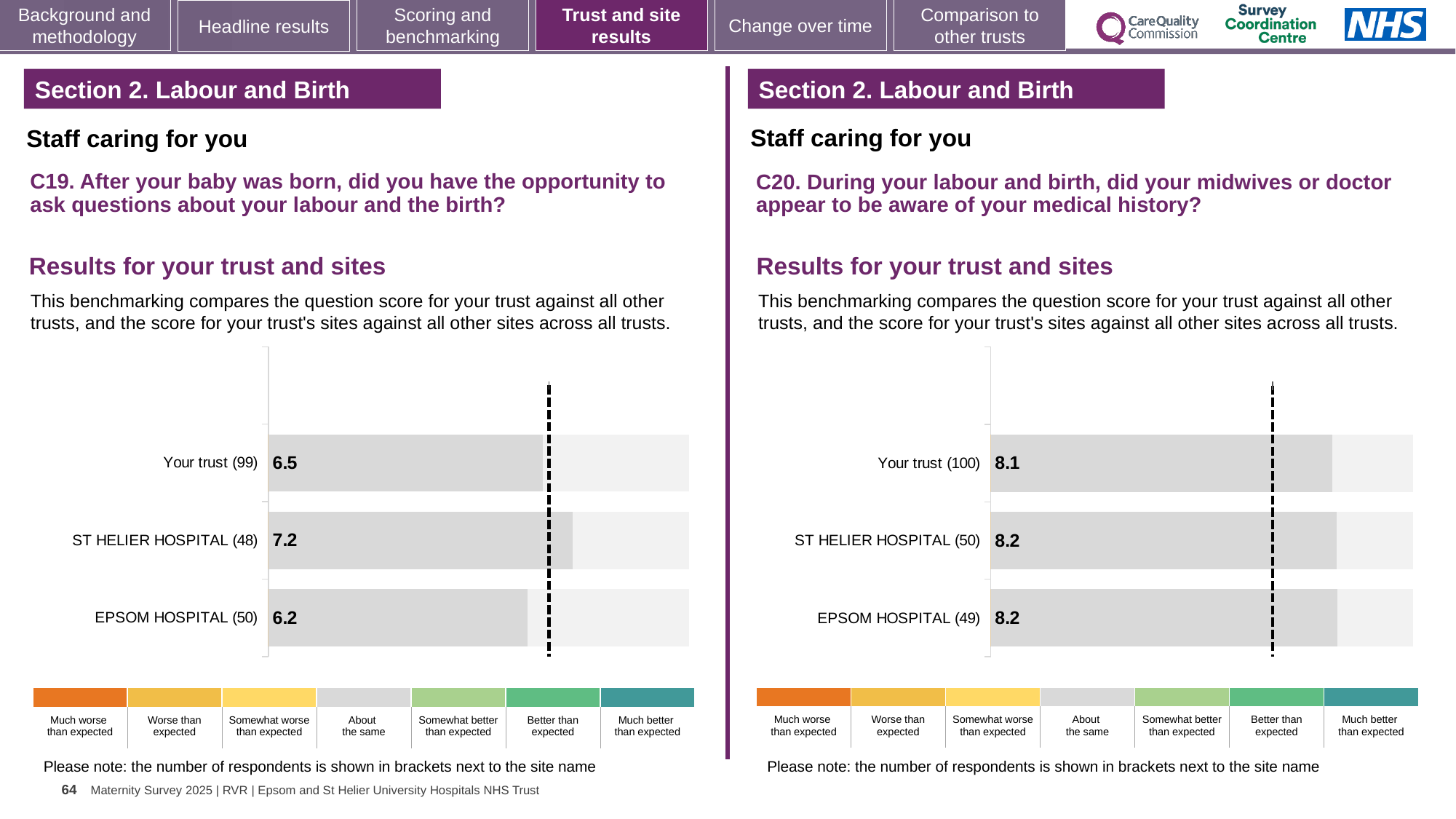
In the C19 chart on the left, what is the score for Your trust? 6.5 In the C20 chart on the right, what is the score for EPSOM HOSPITAL? 8.2 In the C19 chart on the left, is the score for Your trust larger or smaller than the score for ST HELIER HOSPITAL? Smaller In the C20 chart on the right, how many respondents are shown in brackets for ST HELIER HOSPITAL? 50 In the C20 chart on the right, what is the score for Your trust? 8.1 In the C20 chart on the right, how many bars are plotted? 3 In the C19 chart on the left, what is the difference between the ST HELIER HOSPITAL score and the EPSOM HOSPITAL score? 1.0 In the C19 chart on the left, what is the score for ST HELIER HOSPITAL? 7.2 What kind of chart is used in the C19 chart on the left? Bar chart In the C19 chart on the left, what is the score for EPSOM HOSPITAL? 6.2 In the C19 chart on the left, which bar has the lowest score? EPSOM HOSPITAL In the C19 chart on the left, which bar has the highest score? ST HELIER HOSPITAL